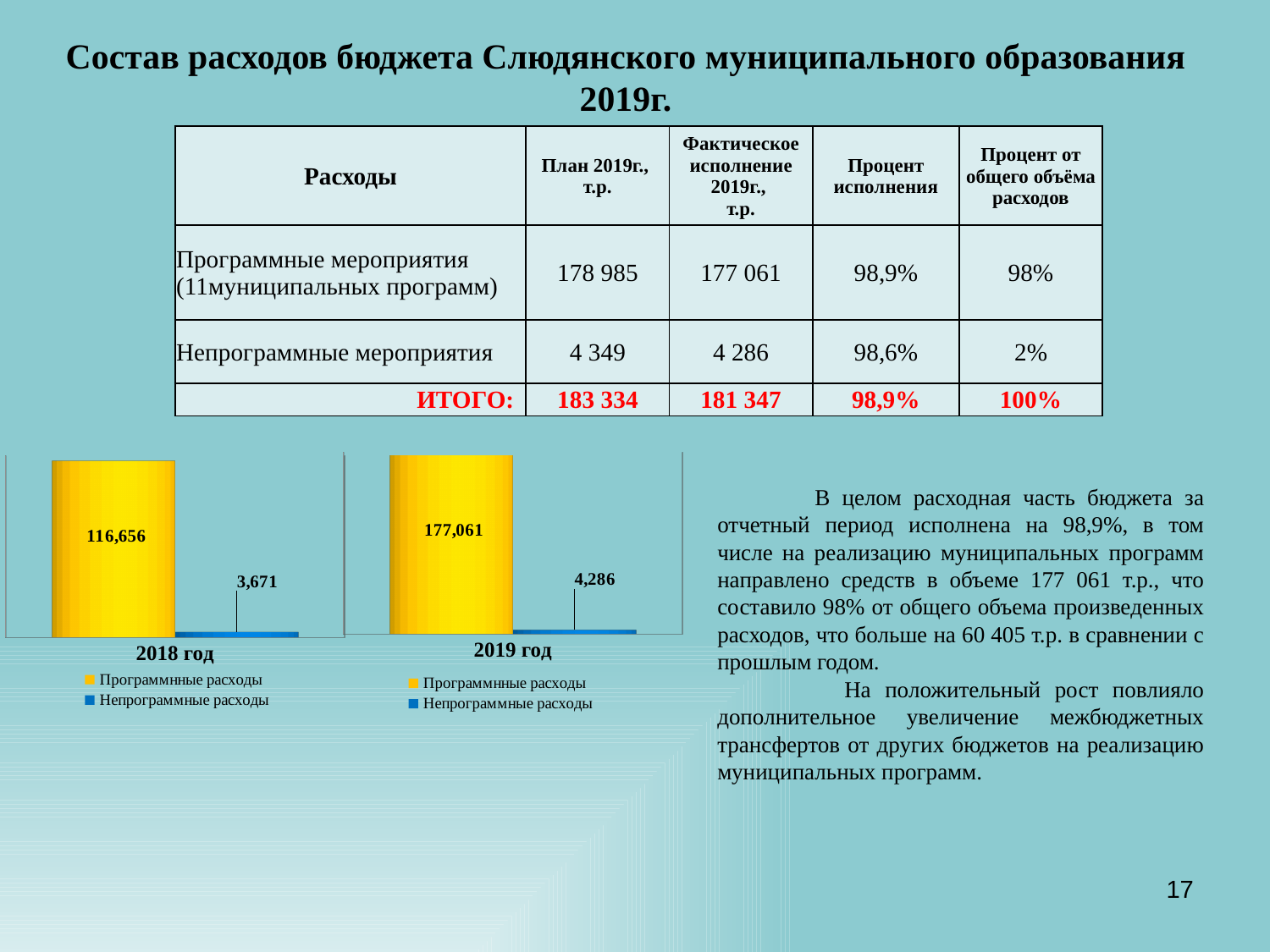
In the right chart (2019 год), which series has the highest value? Программные расходы How many series does the legend of the left chart (2018 год) list? 2 How many bars are plotted in the right chart (2019 год)? 2 In the left chart (2018 год), which series has the lowest value? Непрограммные расходы In the left chart (2018 год), what is the value for Программные расходы? 116,656 In the left chart (2018 год), what is the value for Непрограммные расходы? 3,671 In the right chart (2019 год), what is the difference between Программные расходы and Непрограммные расходы? 172,775 In the left chart (2018 год), what colour are the bars for Программные расходы? yellow Which is larger: Программные расходы in the left chart (2018 год) or Программные расходы in the right chart (2019 год)? 2019 год What kind of chart is the right chart (2019 год)? bar chart In the right chart (2019 год), what is the value for Непрограммные расходы? 4,286 In the right chart (2019 год), what is the value for Программные расходы? 177,061